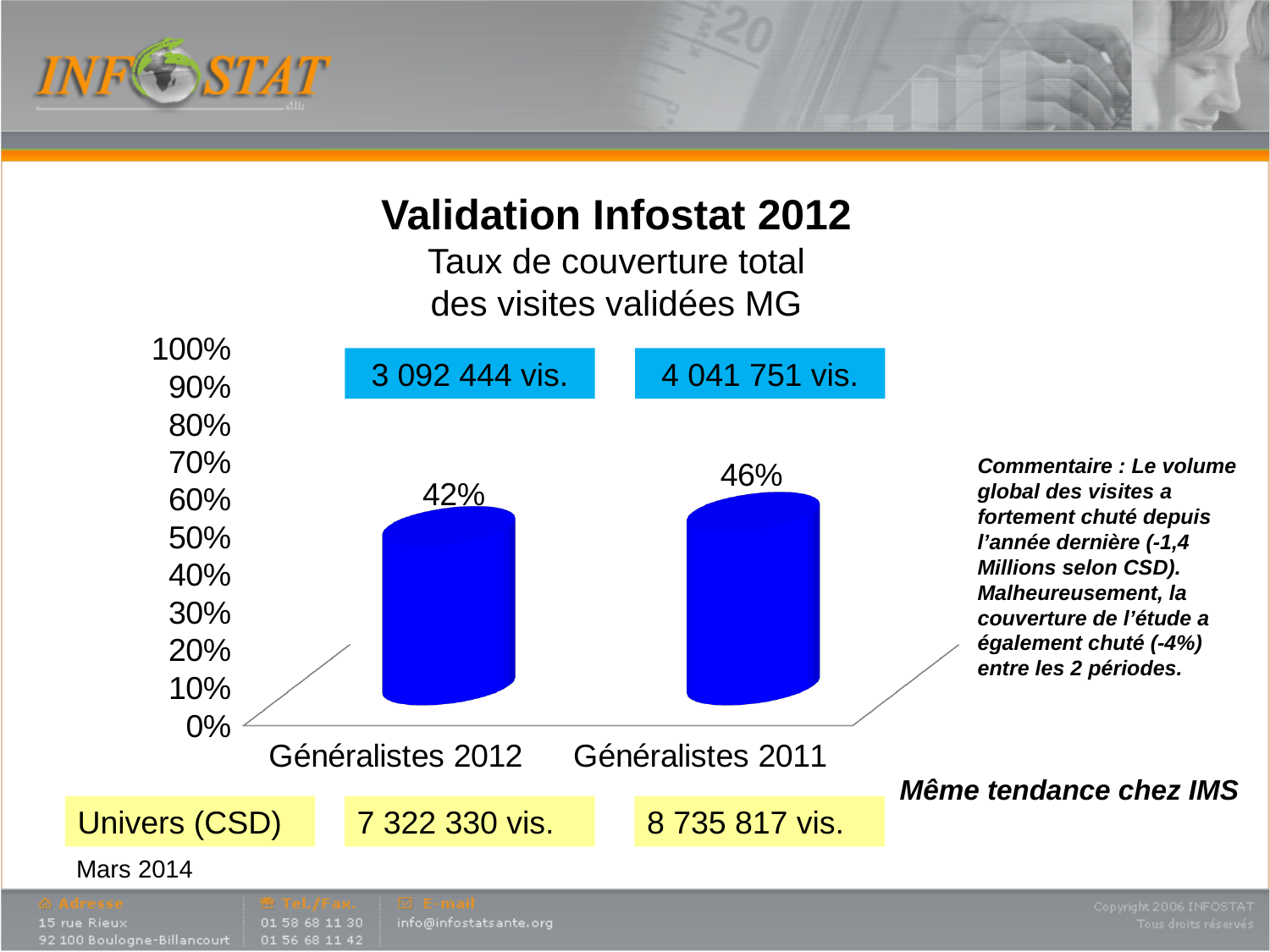
What is the difference between the values for Généralistes 2011 and Généralistes 2012? 4% What is the value for Généralistes 2011? 46% Is the value for Généralistes 2012 greater or less than 50%? less What is the value for Généralistes 2012? 42% What kind of chart is shown on the slide? bar chart Which category has the highest value? Généralistes 2011 Which category has the lowest value? Généralistes 2012 What is the title of the chart? Validation Infostat 2012 What is the maximum value shown on the y axis? 100% How many categories are shown on the x axis? 2 Which is larger, the value for Généralistes 2012 or Généralistes 2011? Généralistes 2011